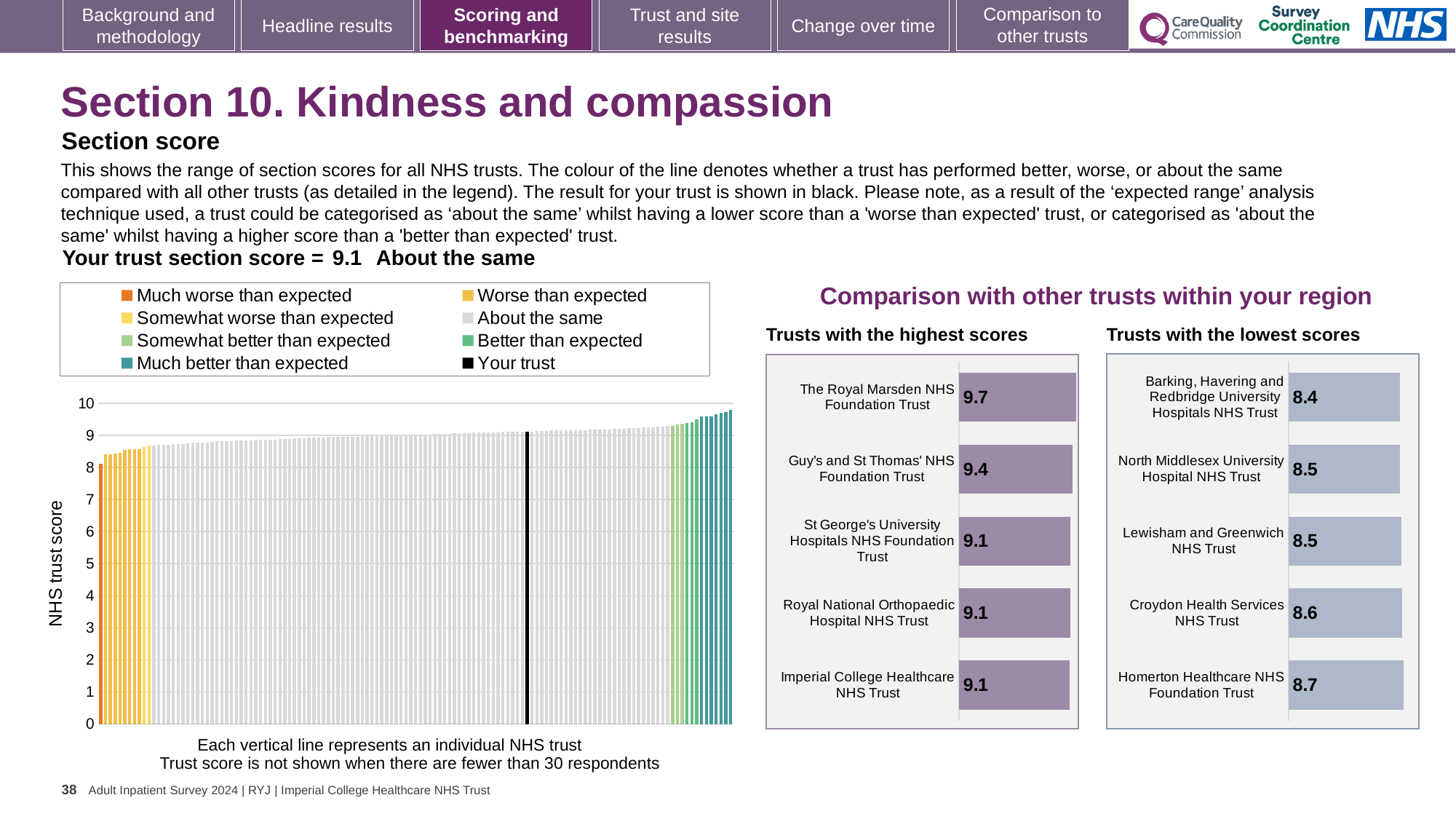
In the 'Trusts with the highest scores' chart, what is the score for Guy's and St Thomas' NHS Foundation Trust? 9.4 In the 'Trusts with the lowest scores' chart, what is the score for Homerton Healthcare NHS Foundation Trust? 8.7 In the 'Trusts with the lowest scores' chart, which has the larger score: Croydon Health Services NHS Trust or North Middlesex University Hospital NHS Trust? Croydon Health Services NHS Trust What kind of chart is the large chart on the left showing all NHS trusts? Bar chart In the 'Trusts with the highest scores' chart, what is the difference between the scores of The Royal Marsden NHS Foundation Trust and Guy's and St Thomas' NHS Foundation Trust? 0.3 How many entries does the legend of the large chart on the left list? 8 In the 'Trusts with the lowest scores' chart, which trust has the lowest score? Barking, Havering and Redbridge University Hospitals NHS Trust How many trusts are shown in the 'Trusts with the highest scores' chart? 5 In the 'Trusts with the highest scores' chart, which trust has the highest score? The Royal Marsden NHS Foundation Trust In the 'Trusts with the highest scores' chart, what is the score for The Royal Marsden NHS Foundation Trust? 9.7 In the 'Trusts with the lowest scores' chart, what is the score for Barking, Havering and Redbridge University Hospitals NHS Trust? 8.4